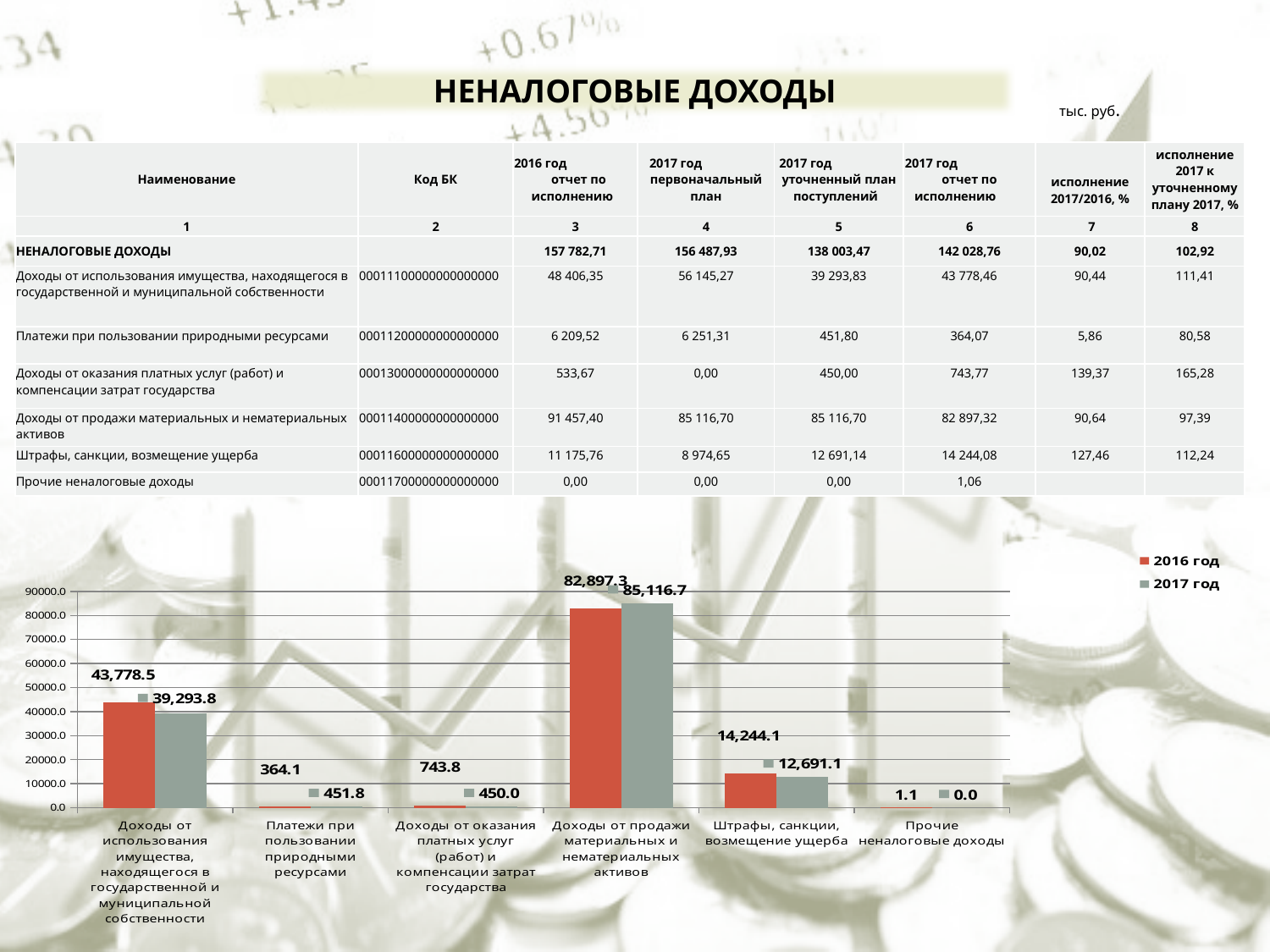
What kind of chart is shown on the slide? bar chart Which colour represents the 2017 год series in the chart? grey Which category has the highest value in the 2016 год series? Доходы от продажи материальных и нематериальных активов How many categories are shown on the x axis of the chart? 6 Is the 2016 год value for 'Доходы от использования имущества, находящегося в государственной и муниципальной собственности' greater or less than 40000.0? greater Which category has the lowest value in the 2017 год series? Прочие неналоговые доходы What is the difference between the 2016 год and 2017 год values for 'Доходы от использования имущества, находящегося в государственной и муниципальной собственности'? 4,484.7 What is the value of the 2017 год series for 'Платежи при пользовании природными ресурсами'? 451.8 For 'Доходы от оказания платных услуг (работ) и компенсации затрат государства', which series has the larger value, 2016 год or 2017 год? 2016 год What is the value of the 2017 год series for 'Доходы от продажи материальных и нематериальных активов'? 85,116.7 How many series does the chart legend list? 2 What is the value of the 2016 год series for 'Штрафы, санкции, возмещение ущерба'? 14,244.1